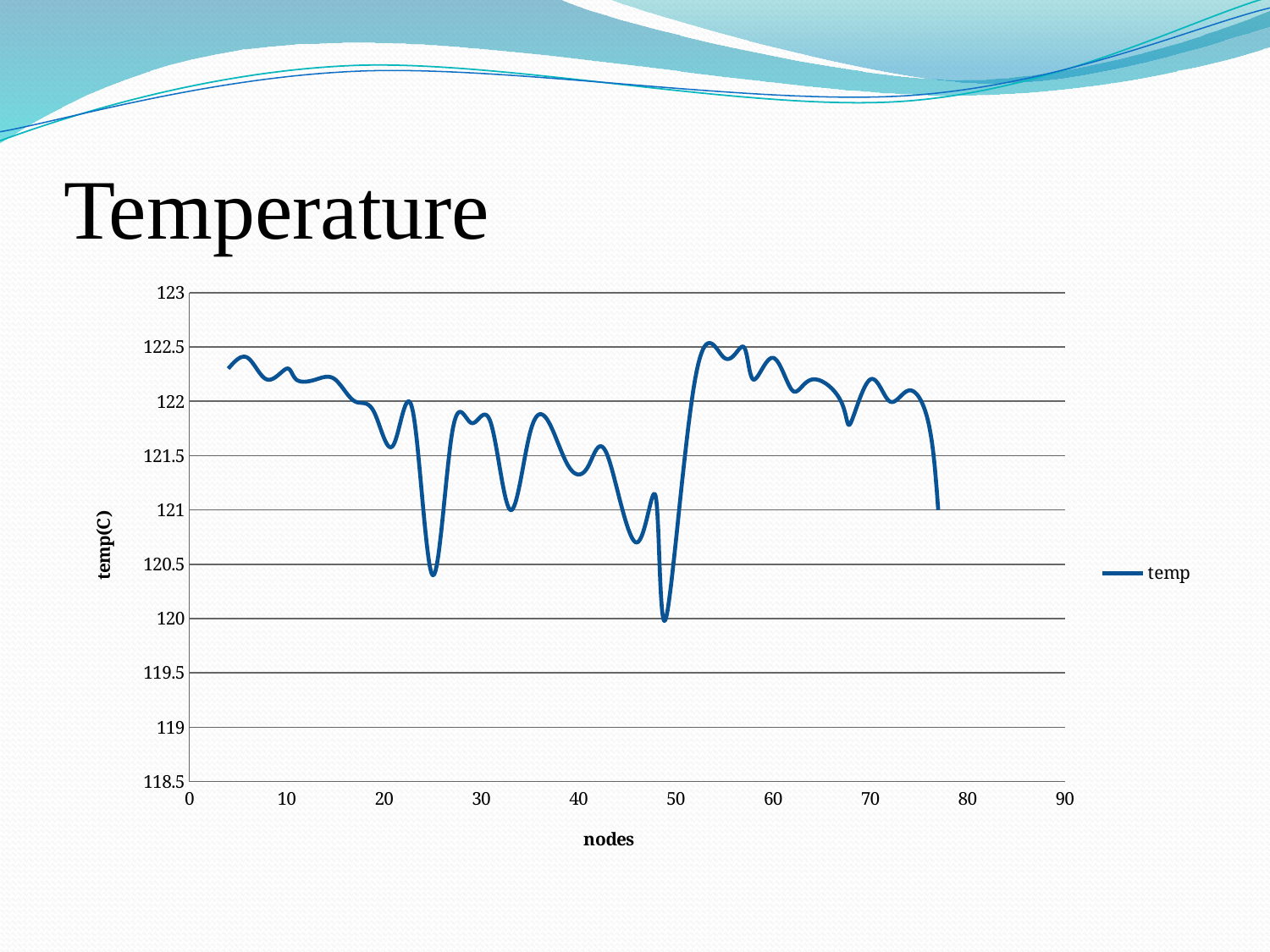
Is the temperature at node 68 greater or less than 122? less Does the temperature rise or fall between node 49 and node 53? rise How many series does the legend list? 1 Is the lowest point of the line located between nodes 40 and 50 or between nodes 50 and 60? between nodes 40 and 50 What is the name of the series shown in the legend? temp Is the temperature at node 49 greater or less than 120.5? less Is the temperature at node 60 greater or less than 122? greater Is the highest point of the line located between nodes 50 and 60 or between nodes 0 and 10? between nodes 50 and 60 What is the label of the x axis? nodes What kind of chart is shown on the slide? line chart